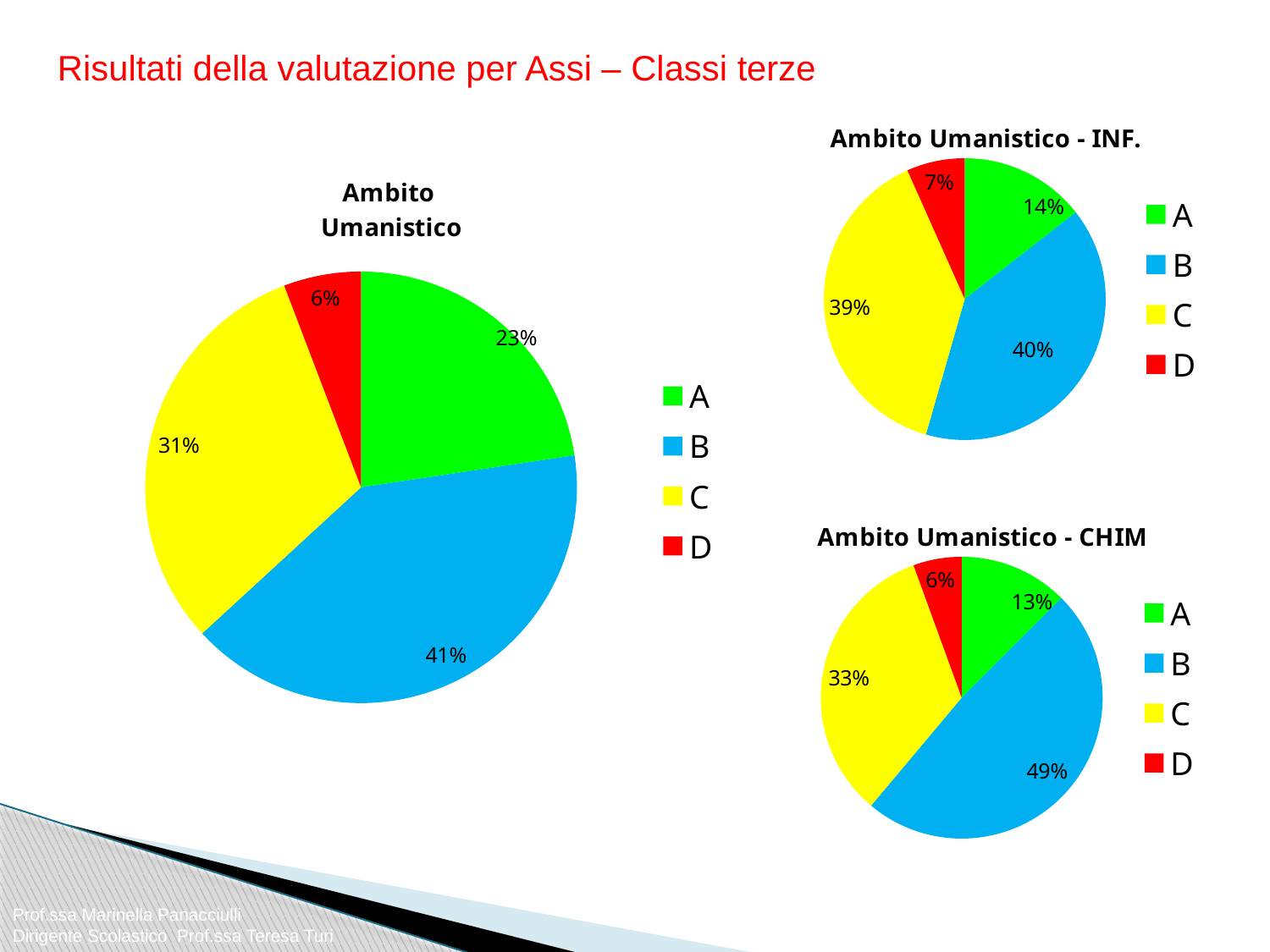
In the 'Ambito Umanistico - CHIM' pie chart, which category has the largest share? B In the 'Ambito Umanistico' pie chart, what share does category B have? 41% In the 'Ambito Umanistico' pie chart, what is the difference between the shares of C and A? 8% How many categories does the legend of the 'Ambito Umanistico - CHIM' chart list? 4 In the 'Ambito Umanistico - CHIM' pie chart, what is the difference between the shares of C and A? 20% In the 'Ambito Umanistico - CHIM' pie chart, what share does category B have? 49% In the 'Ambito Umanistico - INF.' pie chart, which is larger, the share of A or the share of D? A In the 'Ambito Umanistico - INF.' pie chart, what share does category D have? 7% In the 'Ambito Umanistico' pie chart, which category has the largest share? B What type of chart is the 'Ambito Umanistico' chart? Pie chart In the 'Ambito Umanistico' pie chart, which category has the smallest share? D In the 'Ambito Umanistico - INF.' pie chart, what share does category C have? 39%